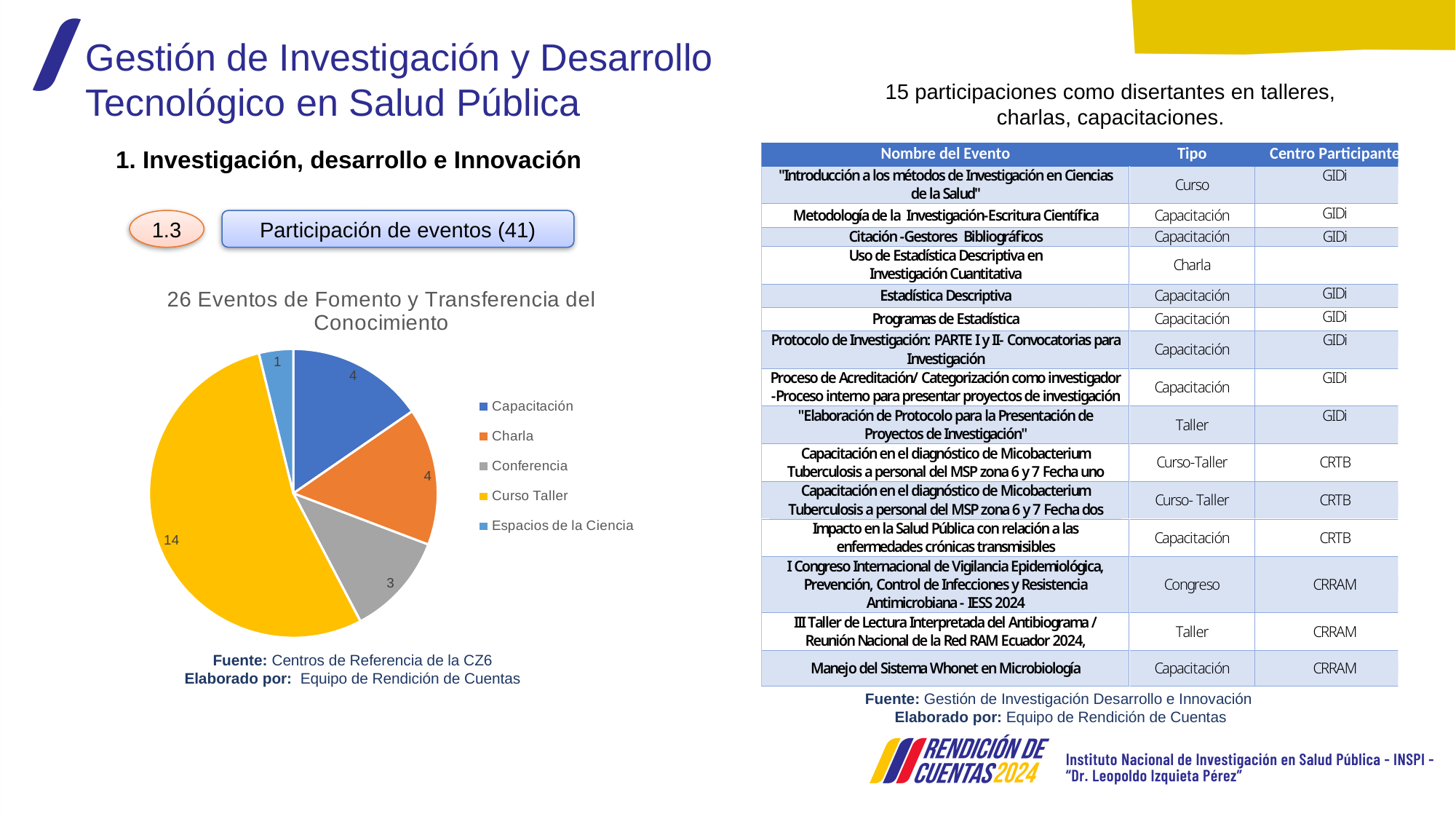
Which colour represents Curso Taller in the pie chart? Yellow What type of chart is shown under the title "26 Eventos de Fomento y Transferencia del Conocimiento"? Pie chart Which category has the largest slice in the pie chart? Curso Taller In the pie chart, what is the value for Conferencia? 3 How many categories does the pie chart's legend list? 5 What is the total of all the slices in the pie chart? 26 In the pie chart, how many events are labelled for Curso Taller? 14 In the pie chart, what is the difference between the values for Curso Taller and Conferencia? 11 Which category has the smallest slice in the pie chart? Espacios de la Ciencia In the pie chart, what is the value for Charla? 4 In the pie chart, what is the value for Espacios de la Ciencia? 1 In the pie chart, which is larger: Conferencia or Capacitación? Capacitación